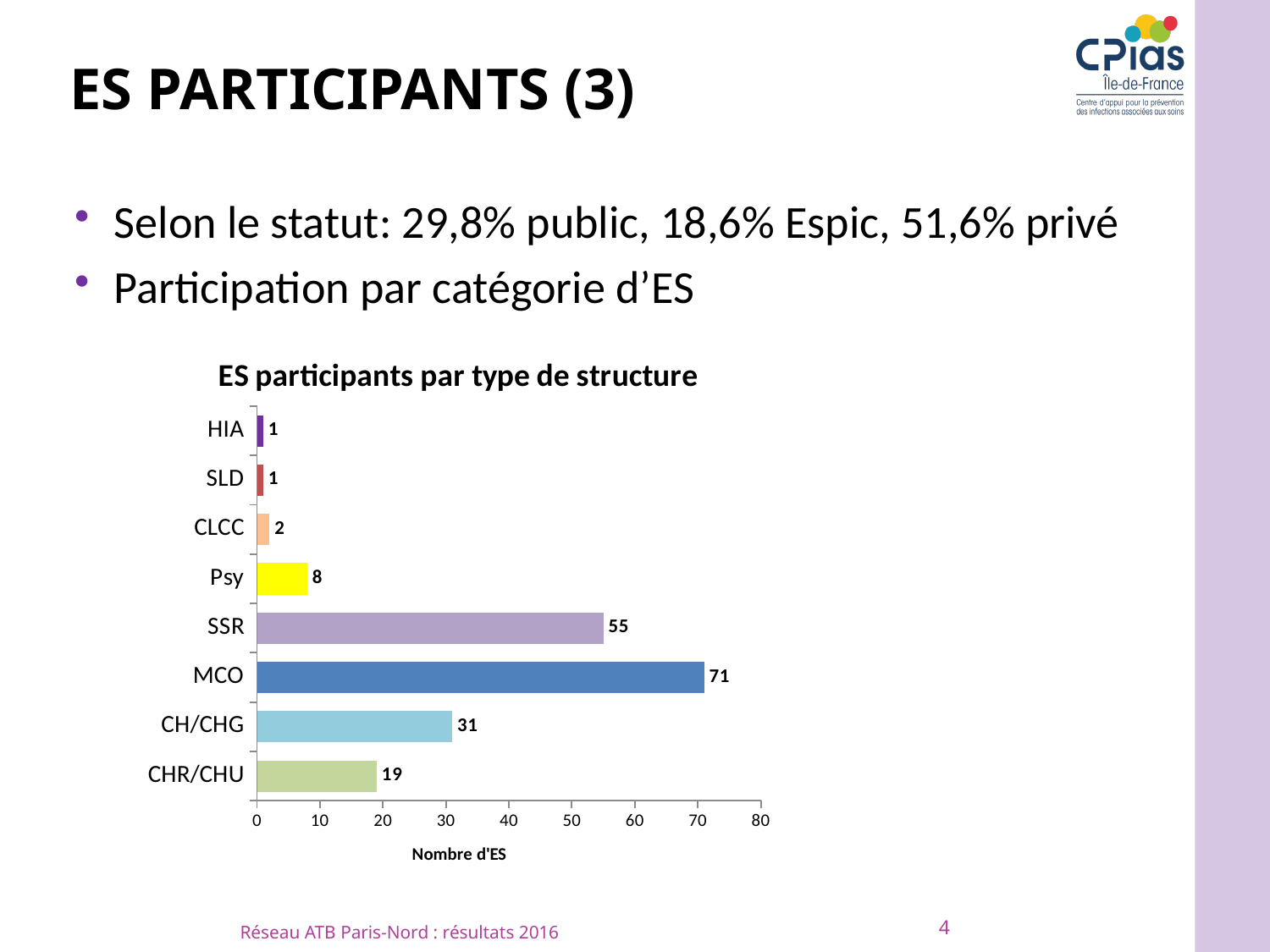
What is the value for MCO in the chart? 71 How many categories (types of structure) are shown in the chart? 8 Which is larger, the value for CH/CHG or the value for CHR/CHU? CH/CHG What is the difference between CH/CHG and CHR/CHU? 12 What kind of chart is shown on the slide? bar chart What is the title of the chart? ES participants par type de structure How many ES are shown for SSR? 55 Is the value for SSR greater or less than 50? greater What is the difference between the values for MCO and SSR? 16 Which category has the lowest value, CLCC or Psy? CLCC What is the value for CHR/CHU? 19 Which type of structure has the highest number of ES? MCO